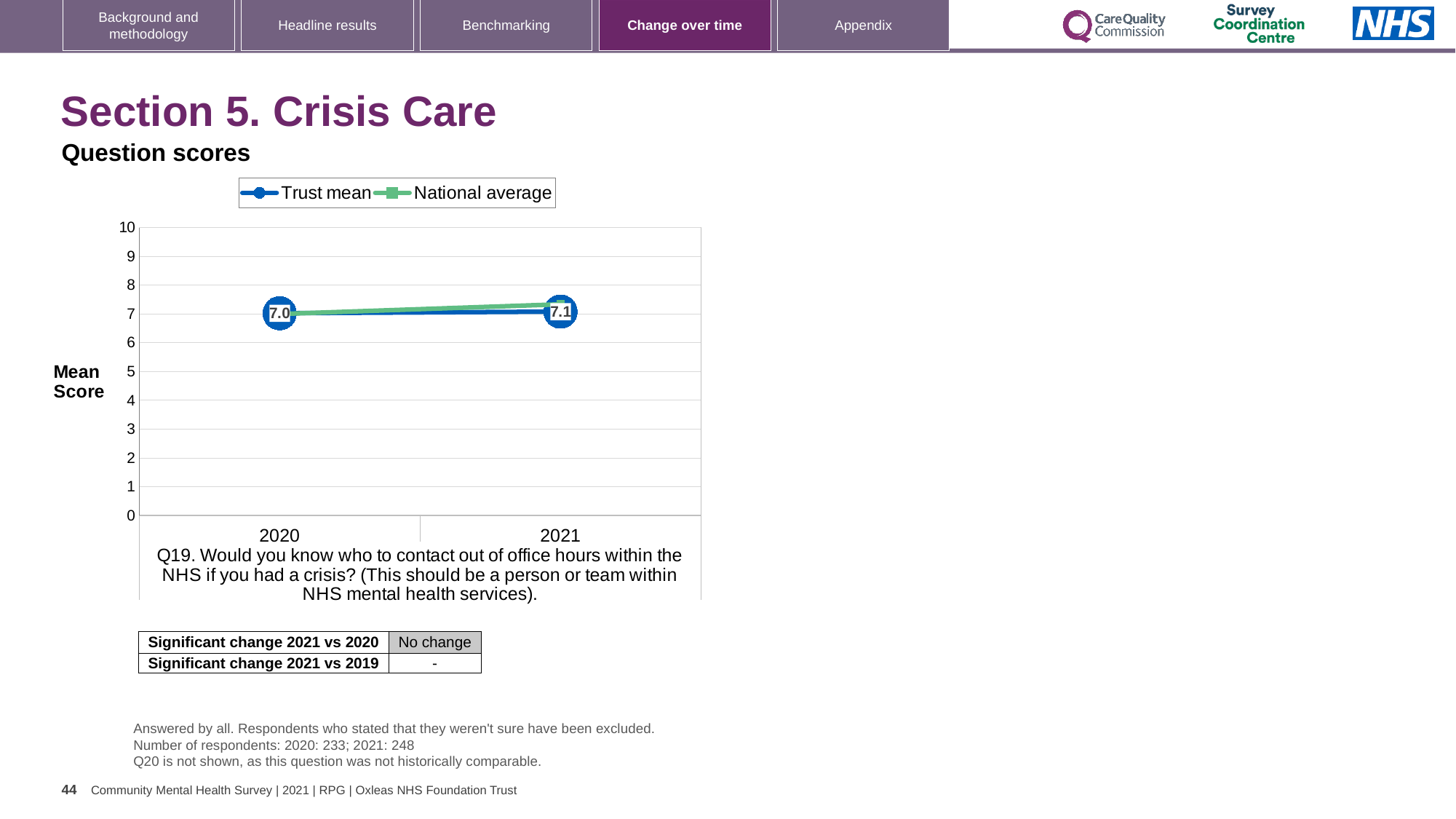
What is the Trust mean score for 2020? 7.0 What is the Trust mean score for 2021? 7.1 Is the National average value for 2021 greater or less than 5? greater Does the Trust mean rise or fall from 2020 to 2021? rise What kind of chart is shown on the slide? line chart What is the label on the y axis of the chart? Mean Score Which year has the higher Trust mean score, 2020 or 2021? 2021 What are the two series named in the chart legend? Trust mean and National average How many series does the chart legend list? 2 Is the National average value for 2020 greater or less than 8? less How many years are plotted on the x axis of the chart? 2 By how much did the Trust mean score change from 2020 to 2021? 0.1